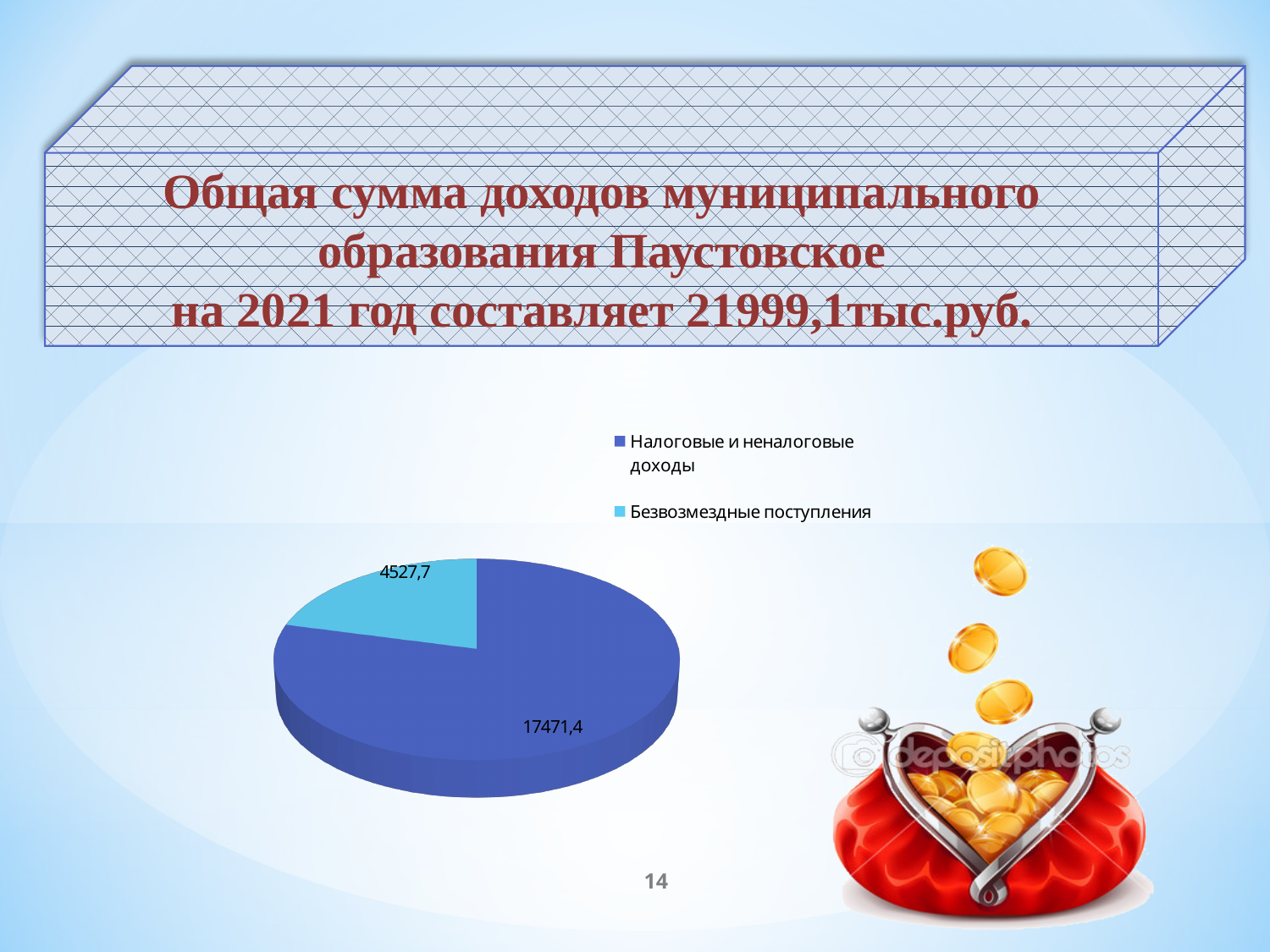
What is the difference between Налоговые и неналоговые доходы and Безвозмездные поступления? 12943,7 Which category has the smallest slice of the pie? Безвозмездные поступления How many slices does the pie chart have? 2 What share of the pie does Налоговые и неналоговые доходы represent? 79.4% Which is larger: Налоговые и неналоговые доходы or Безвозмездные поступления? Налоговые и неналоговые доходы How many entries does the legend list? 2 What is the value for Безвозмездные поступления? 4527,7 What is the value for Налоговые и неналоговые доходы? 17471,4 What is the total of the two slices in the pie chart? 21999,1 What colour is the slice for Безвозмездные поступления? light blue What kind of chart is shown on the slide? pie chart Which category has the largest slice of the pie? Налоговые и неналоговые доходы